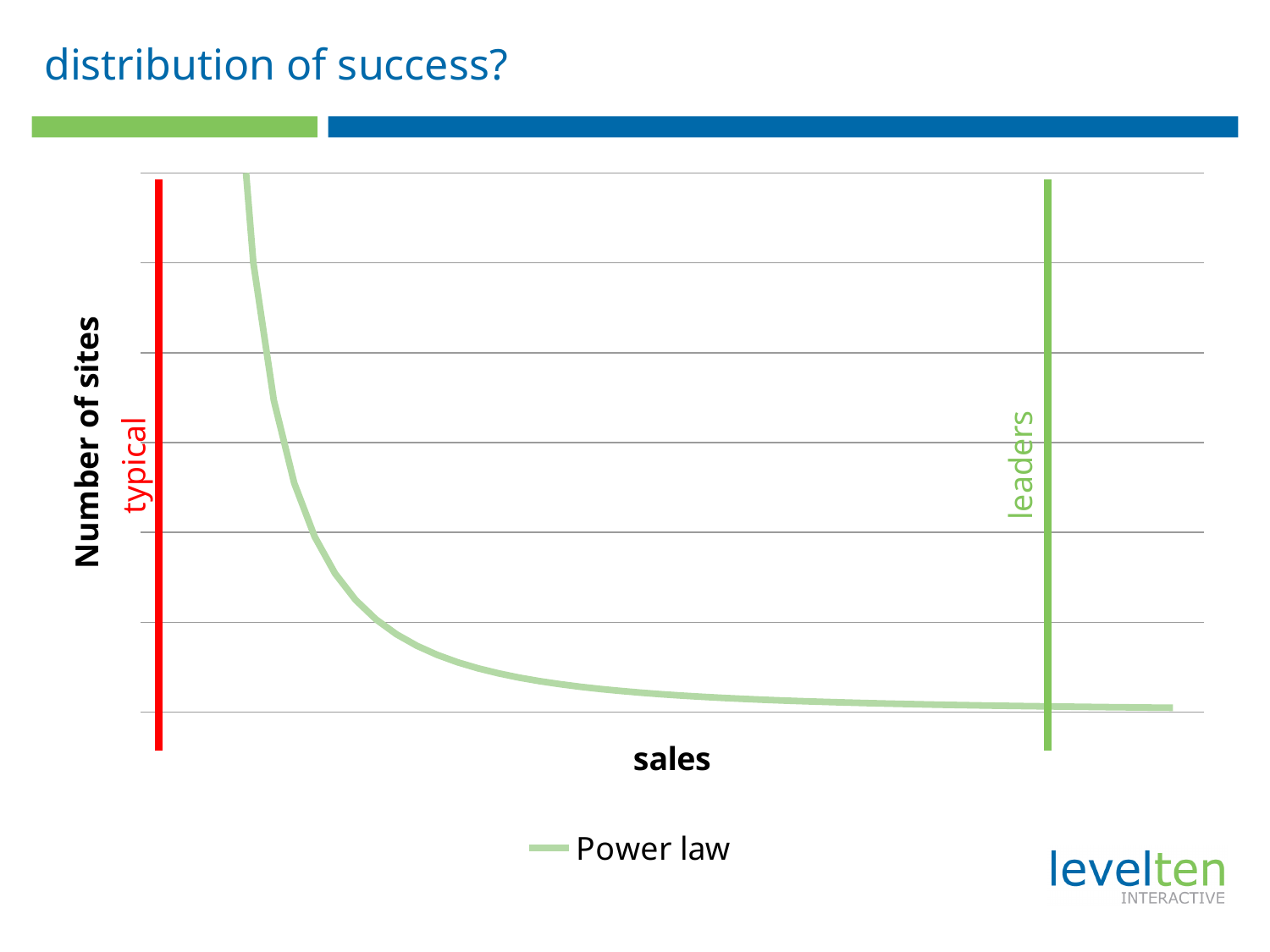
How many series does the legend list? 1 What is the name of the series shown in the legend? Power law Do the values of the Power law series rise or fall as sales increase along the x axis? fall What kind of chart is shown on the slide? line chart What is the label of the vertical axis? Number of sites